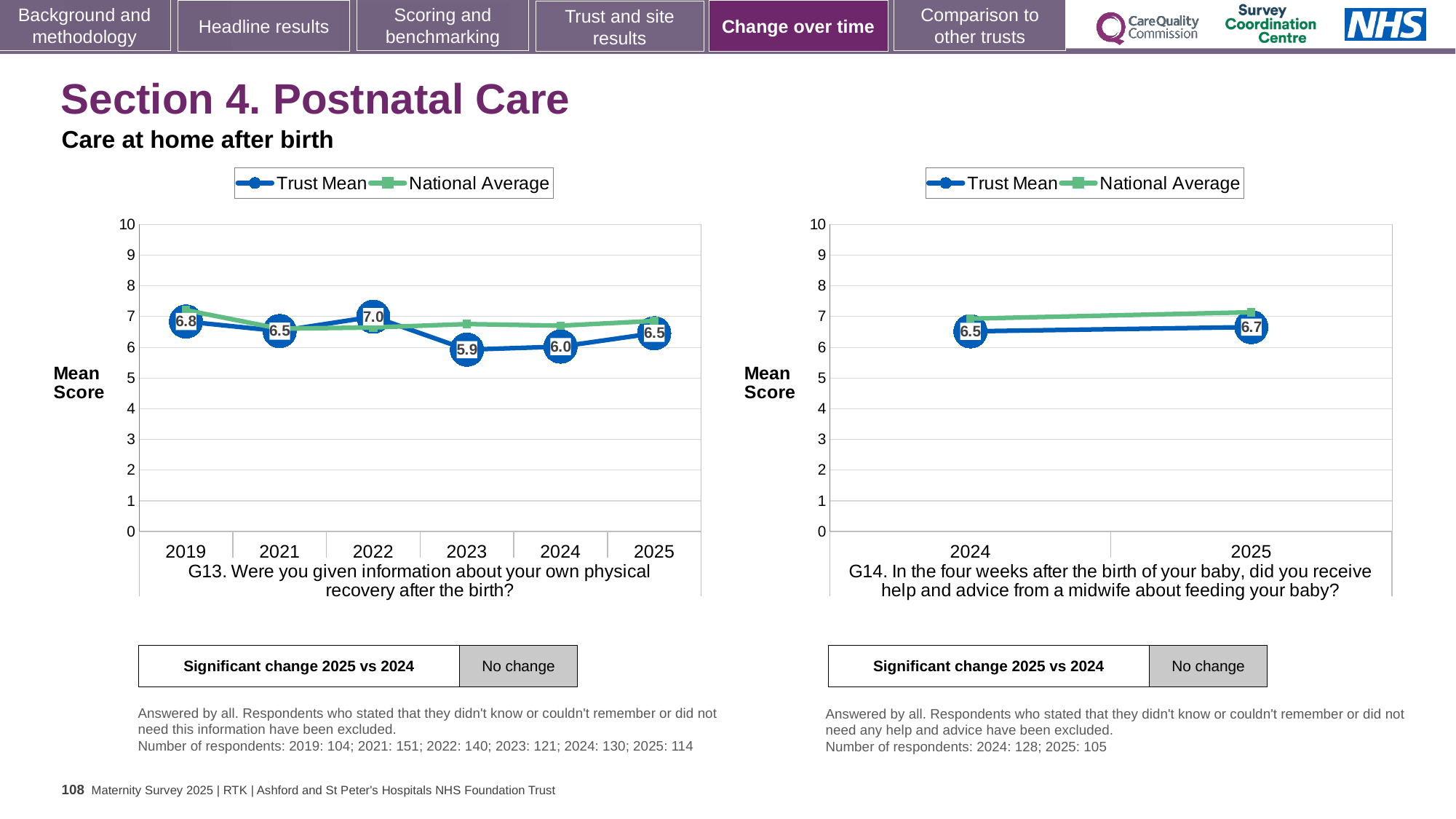
On the G13 chart (left), what is the difference between the Trust Mean in 2022 and in 2023? 1.1 On the G13 chart (left), what is the Trust Mean for 2022? 7.0 On the G14 chart (right), does the Trust Mean rise or fall from 2024 to 2025? rise On the G13 chart (left), what is the Trust Mean for 2023? 5.9 On the G13 chart (left), which year has the highest Trust Mean? 2022 How many series does the legend of the G14 chart (right) list? 2 On the G13 chart (left), how many years are plotted on the x axis? 6 On the G13 chart (left), is the Trust Mean for 2019 greater or less than the National Average for 2019? less On the G14 chart (right), what is the Trust Mean for 2025? 6.7 What type of chart is the G13 chart (left)? line chart On the G13 chart (left), which year has the lowest Trust Mean? 2023